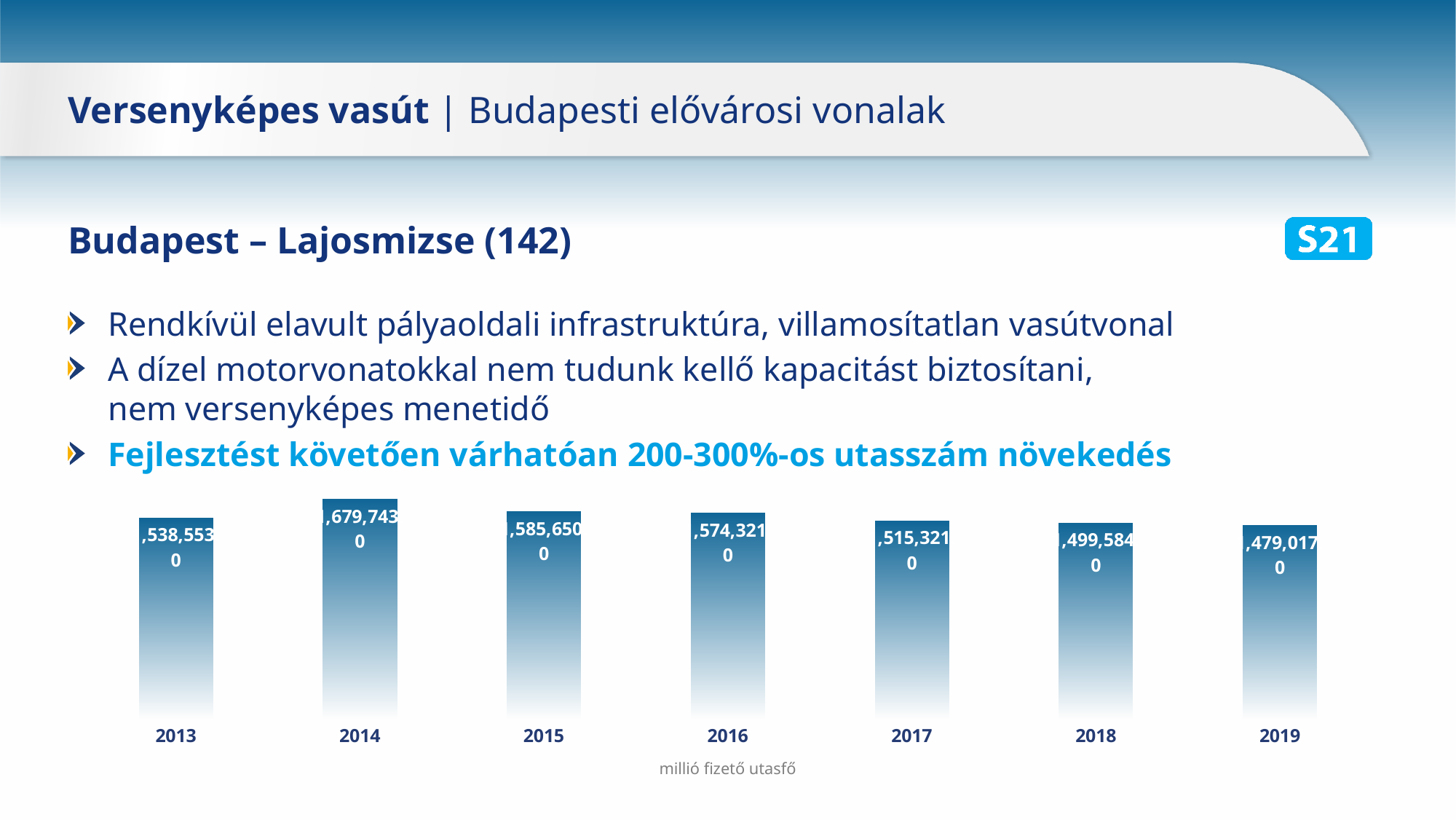
Which year has the shortest bar in the chart? 2019 What is the first year shown on the x axis of the chart? 2013 Which bar is taller, 2014 or 2017? 2014 What unit caption is printed below the chart? millió fizető utasfő What kind of chart is shown on the slide? bar chart Does the value rise or fall from 2013 to 2014? rise How many bars (years) does the chart show? 7 Which bar is taller, 2014 or 2019? 2014 Do the bar values rise or fall from 2014 to 2019? fall Which year has the tallest bar in the chart? 2014